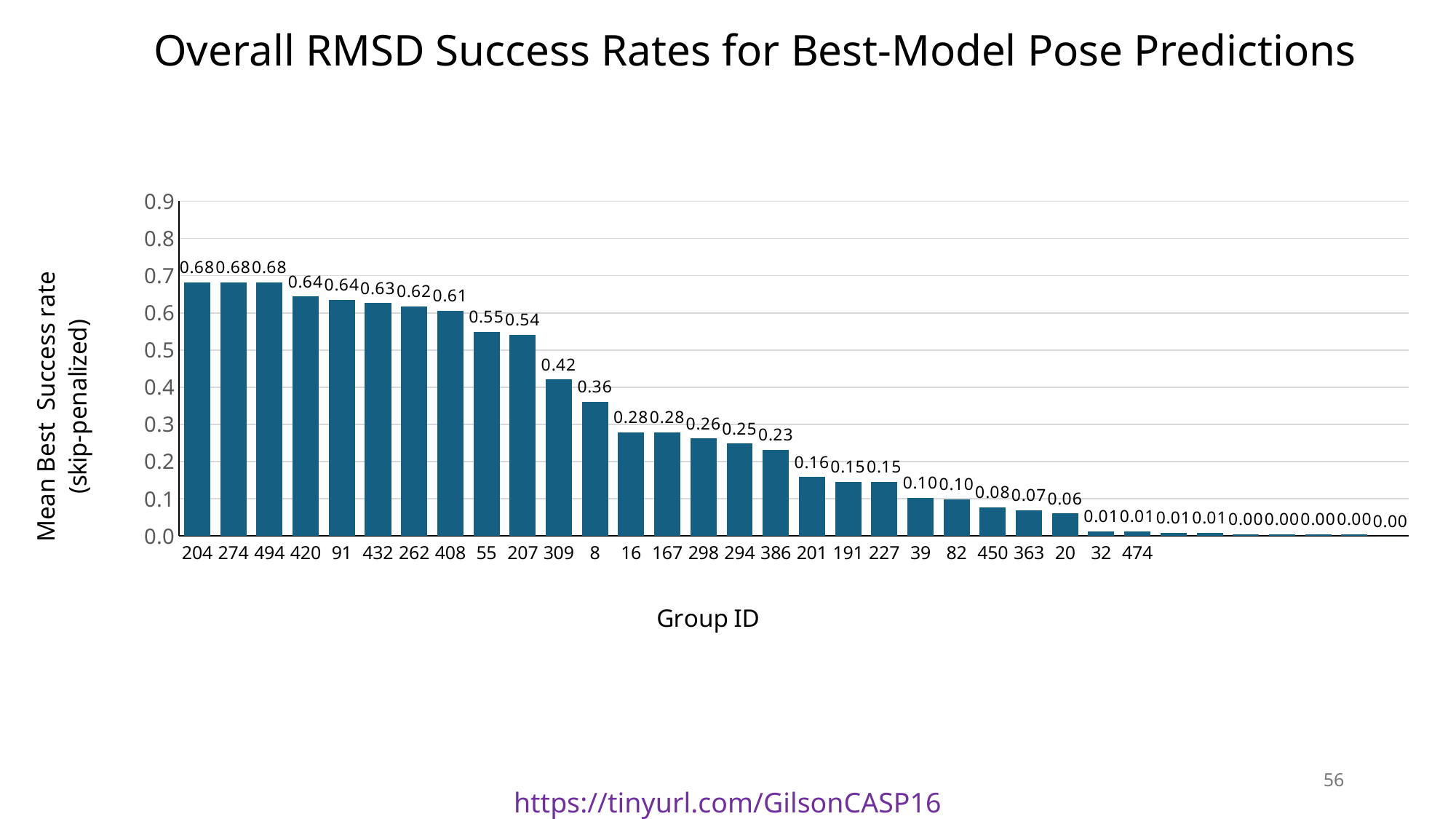
What is the difference between the values for Group ID 204 and Group ID 20? 0.62 Which has a larger value, Group ID 207 or Group ID 309? 207 What is the value for Group ID 8? 0.36 What is the difference between the values for Group ID 309 and Group ID 8? 0.06 What is the value for Group ID 20? 0.06 What kind of chart is shown on the slide? bar chart What is the value for Group ID 309? 0.42 Is the value for Group ID 432 greater or less than 0.6? greater What is the title of the y axis? Mean Best Success rate (skip-penalized) Do the values rise or fall from left to right along the x axis? fall What is the highest value shown on the chart? 0.68 What is the value for Group ID 386? 0.23